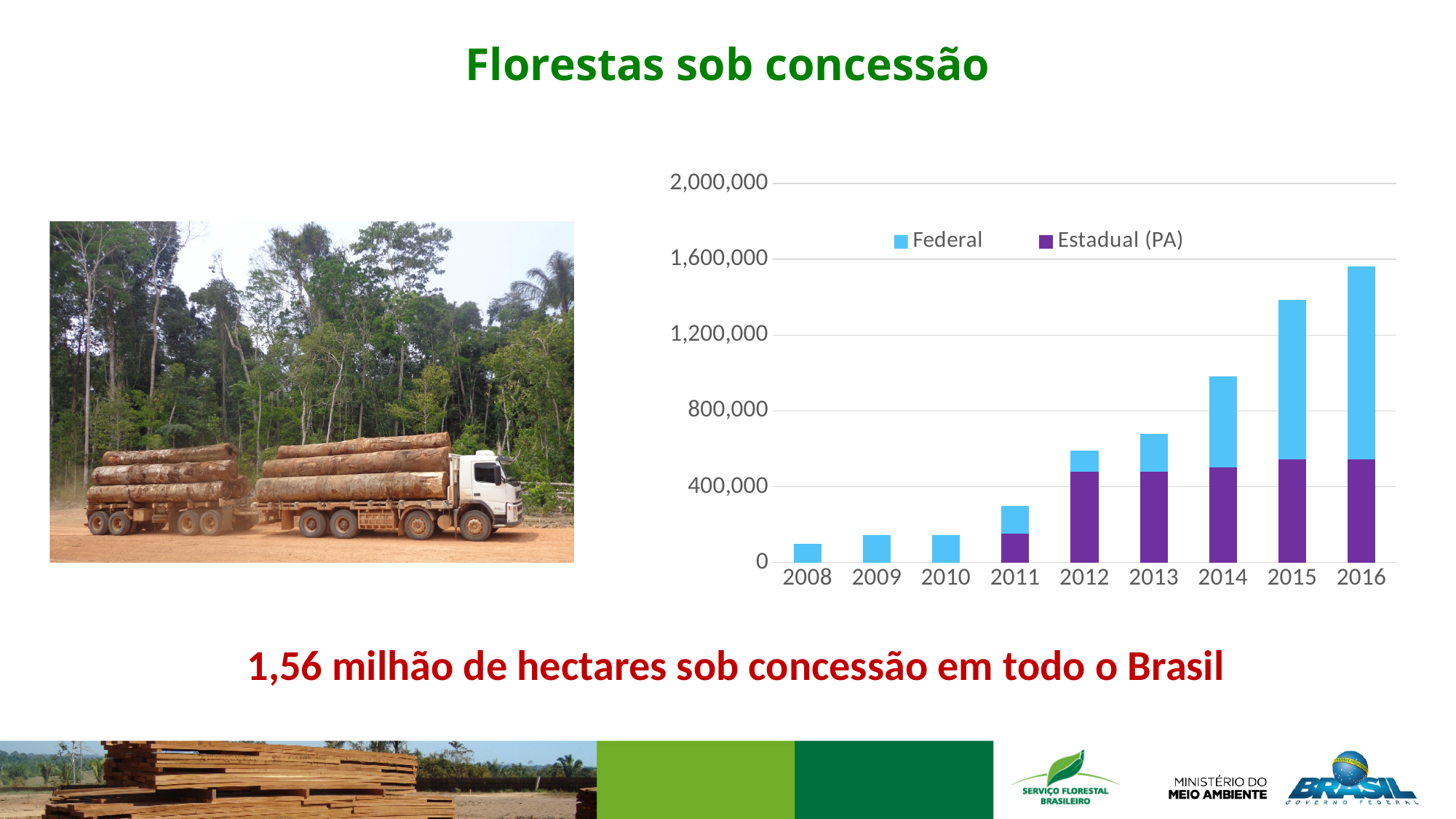
In 2016, which series has the larger segment, Federal or Estadual (PA)? Federal How many years are shown on the x axis of the chart? 9 Which year has the highest total bar in the chart? 2016 How many series does the chart legend list? 2 What are the two series named in the chart legend? Federal and Estadual (PA) What kind of chart is shown on the slide? Stacked bar chart Is the total value for 2008 greater or less than 400,000? less Do the total bar heights rise or fall from 2008 to 2016? Rise Is the total value for 2015 greater or less than 1,200,000? greater Is the total value for 2016 greater or less than 2,000,000? less Which year has the lowest total bar in the chart? 2008 In 2012, which series has the larger segment, Federal or Estadual (PA)? Estadual (PA)